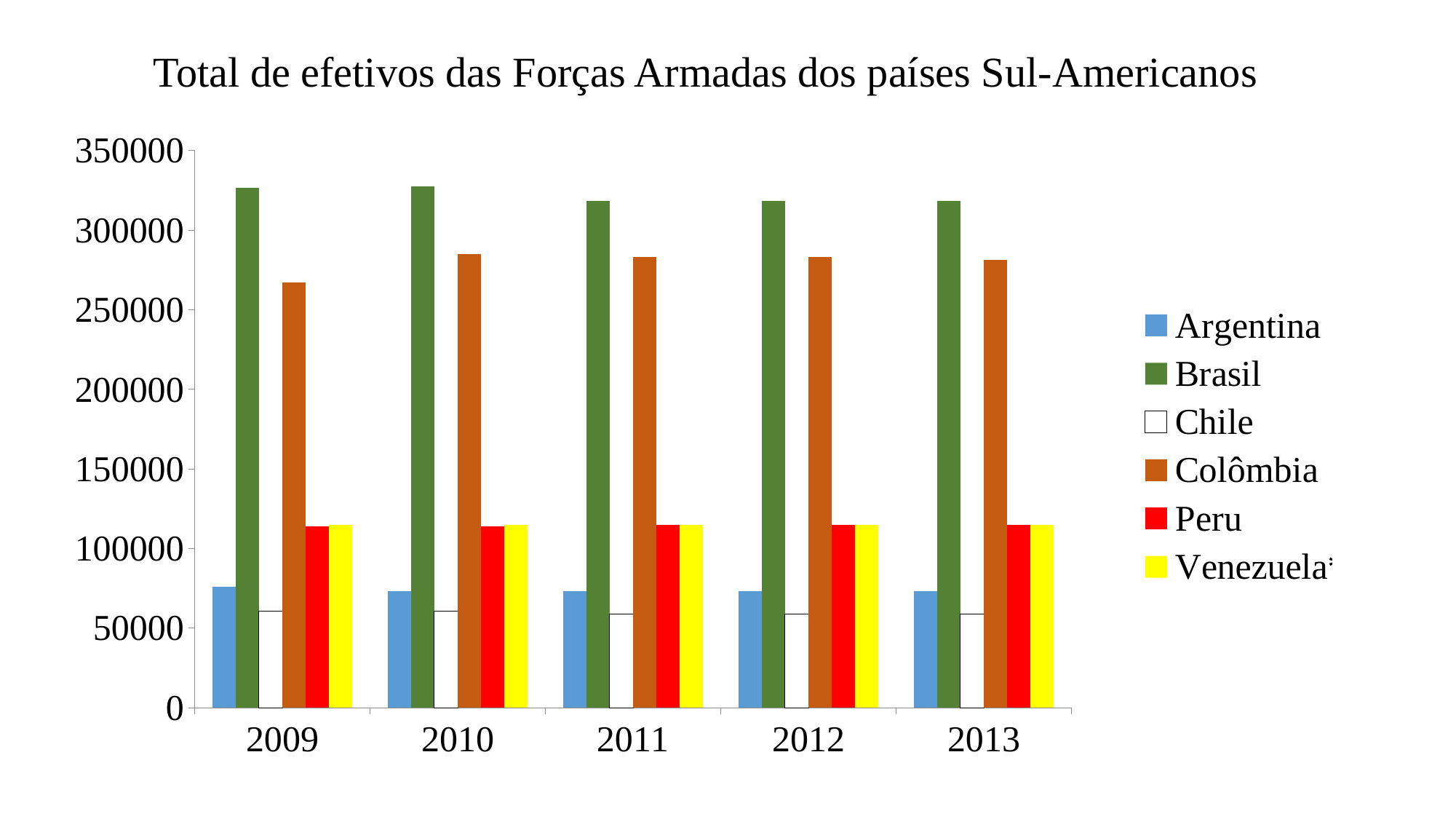
Which country has the highest value in 2009? Brasil In 2012, which is larger, the value for Argentina or the value for Chile? Argentina Is the value for Colômbia in 2009 greater or less than 250000? greater Is the value for Argentina in 2009 greater or less than 100000? less What is the title of the chart? Total de efetivos das Forças Armadas dos países Sul-Americanos Is the value for Brasil in 2010 greater or less than 300000? greater Which country has the lowest value in 2013? Chile How many years are shown on the x axis? 5 In 2011, which is larger, the value for Brasil or the value for Colômbia? Brasil How many series does the legend list? 6 What kind of chart is shown on the slide? bar chart Does the value for Colômbia rise or fall from 2009 to 2010? rise